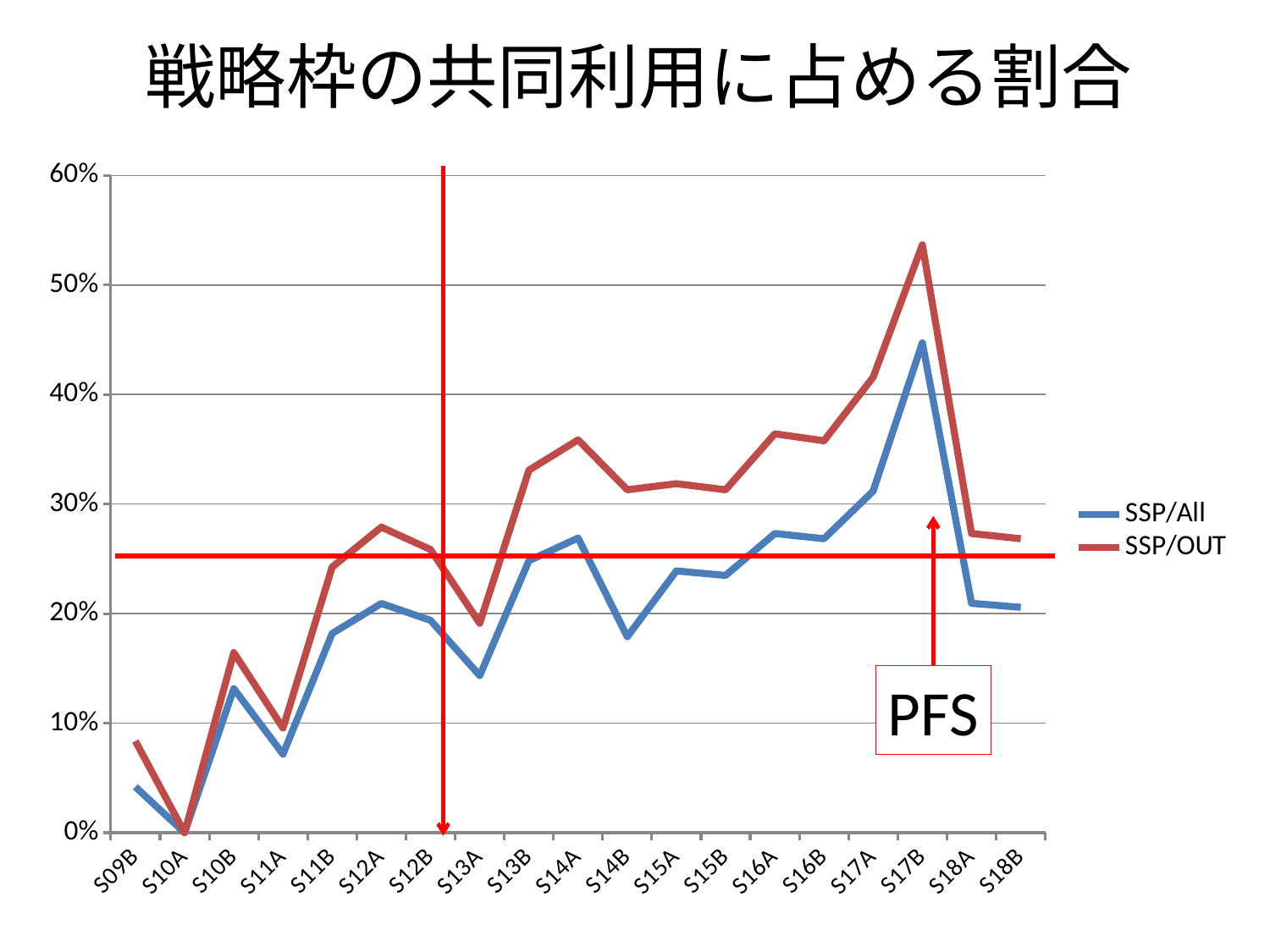
What is the value of SSP/All at S10A? 0% At which category does the SSP/OUT series reach its highest value? S17B At S17B, which series has the larger value, SSP/All or SSP/OUT? SSP/OUT What kind of chart is shown on the slide? line chart Is the value for SSP/OUT at S13B greater or less than 30%? greater How many series does the legend list? 2 What label is shown in the box with the arrow pointing at the S17B peak? PFS At which category does the SSP/All series reach its lowest value? S10A Is the value for SSP/OUT at S17B greater or less than 50%? greater Is the value for SSP/All at S14B greater or less than 20%? less Which series is drawn in red? SSP/OUT How many categories are shown on the x axis? 19